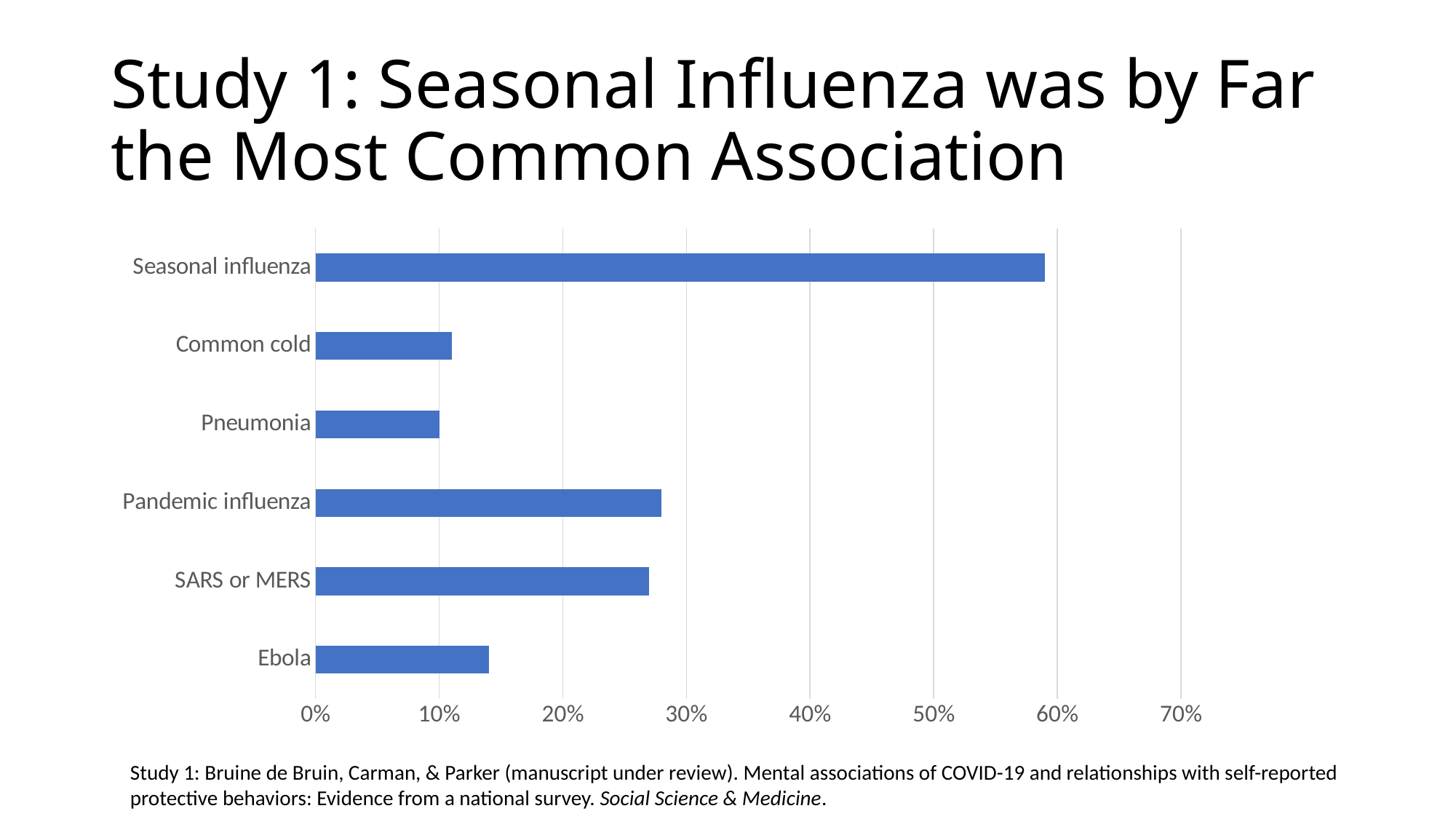
Is the value for Seasonal influenza greater or less than 50%? greater Is the value for Pandemic influenza greater or less than 20%? greater Is the value for Ebola greater or less than 10%? greater Which is larger, the value for Ebola or the value for Common cold? Ebola How many categories are plotted in the chart? 6 What is the highest value shown on the horizontal axis of the chart? 70% What kind of chart is shown on the slide? Bar chart Which category has the highest value in the chart? Seasonal influenza Which is larger, the value for Seasonal influenza or the value for Pandemic influenza? Seasonal influenza